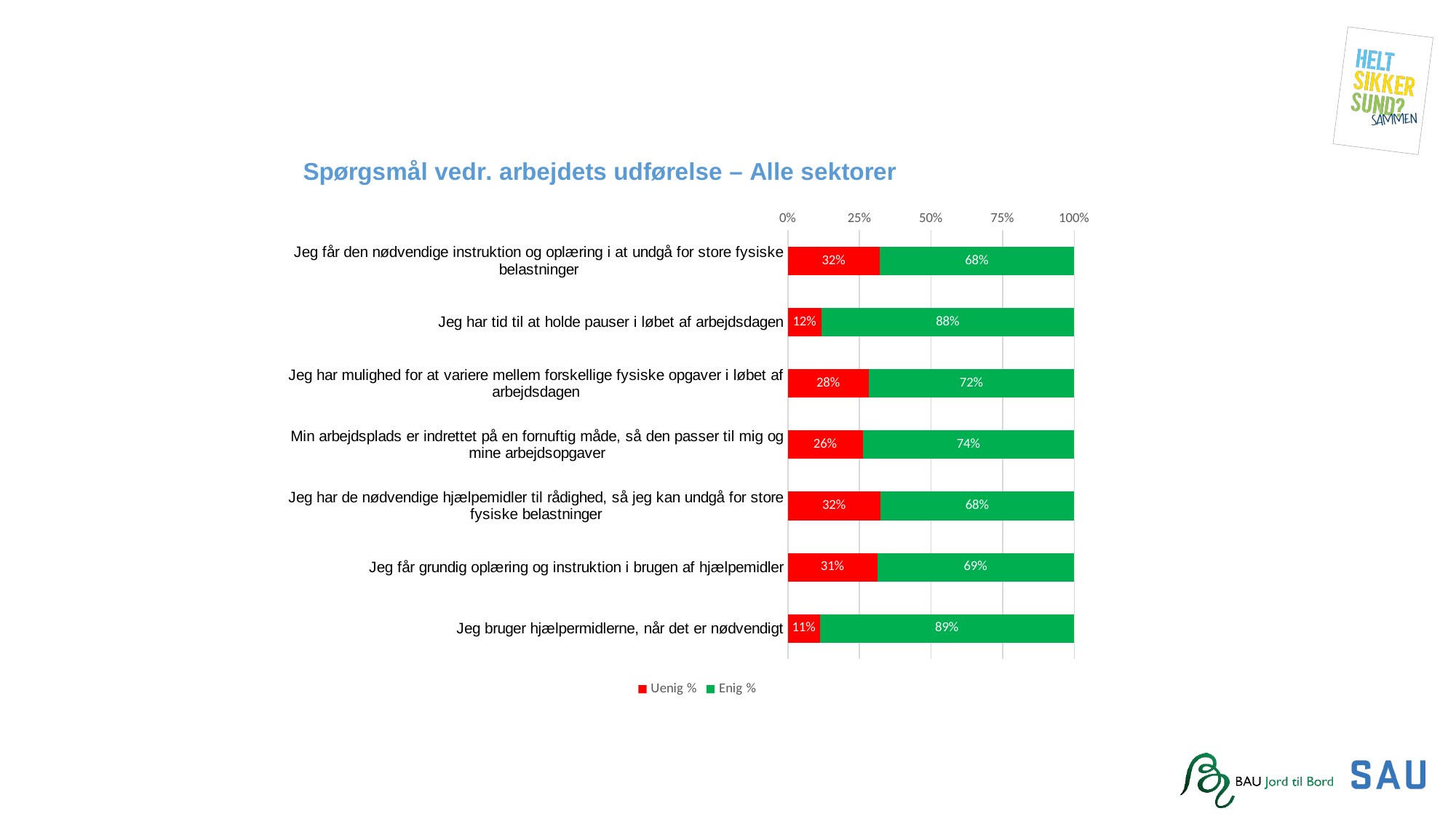
How many statements (categories) are shown in the chart? 7 What is the difference between the Enig % values for "Jeg har tid til at holde pauser i løbet af arbejdsdagen" and "Jeg får den nødvendige instruktion og oplæring i at undgå for store fysiske belastninger"? 20 percentage points What is the title of the chart on the slide? Spørgsmål vedr. arbejdets udførelse – Alle sektorer What is the Uenig % value for "Jeg får grundig oplæring og instruktion i brugen af hjælpemidler"? 31% Which statement has the lowest Uenig % value? Jeg bruger hjælpermidlerne, når det er nødvendigt Which has a larger Enig % value: "Jeg har mulighed for at variere mellem forskellige fysiske opgaver i løbet af arbejdsdagen" or "Jeg får grundig oplæring og instruktion i brugen af hjælpemidler"? Jeg har mulighed for at variere mellem forskellige fysiske opgaver i løbet af arbejdsdagen What is the Enig % value for "Jeg har tid til at holde pauser i løbet af arbejdsdagen"? 88% What is the Enig % value for "Min arbejdsplads er indrettet på en fornuftig måde, så den passer til mig og mine arbejdsopgaver"? 74% What is the Uenig % value for "Jeg har mulighed for at variere mellem forskellige fysiske opgaver i løbet af arbejdsdagen"? 28% Which statement has the highest Enig % value? Jeg bruger hjælpermidlerne, når det er nødvendigt What type of chart is shown on the slide? Stacked bar chart How many series does the legend list? 2